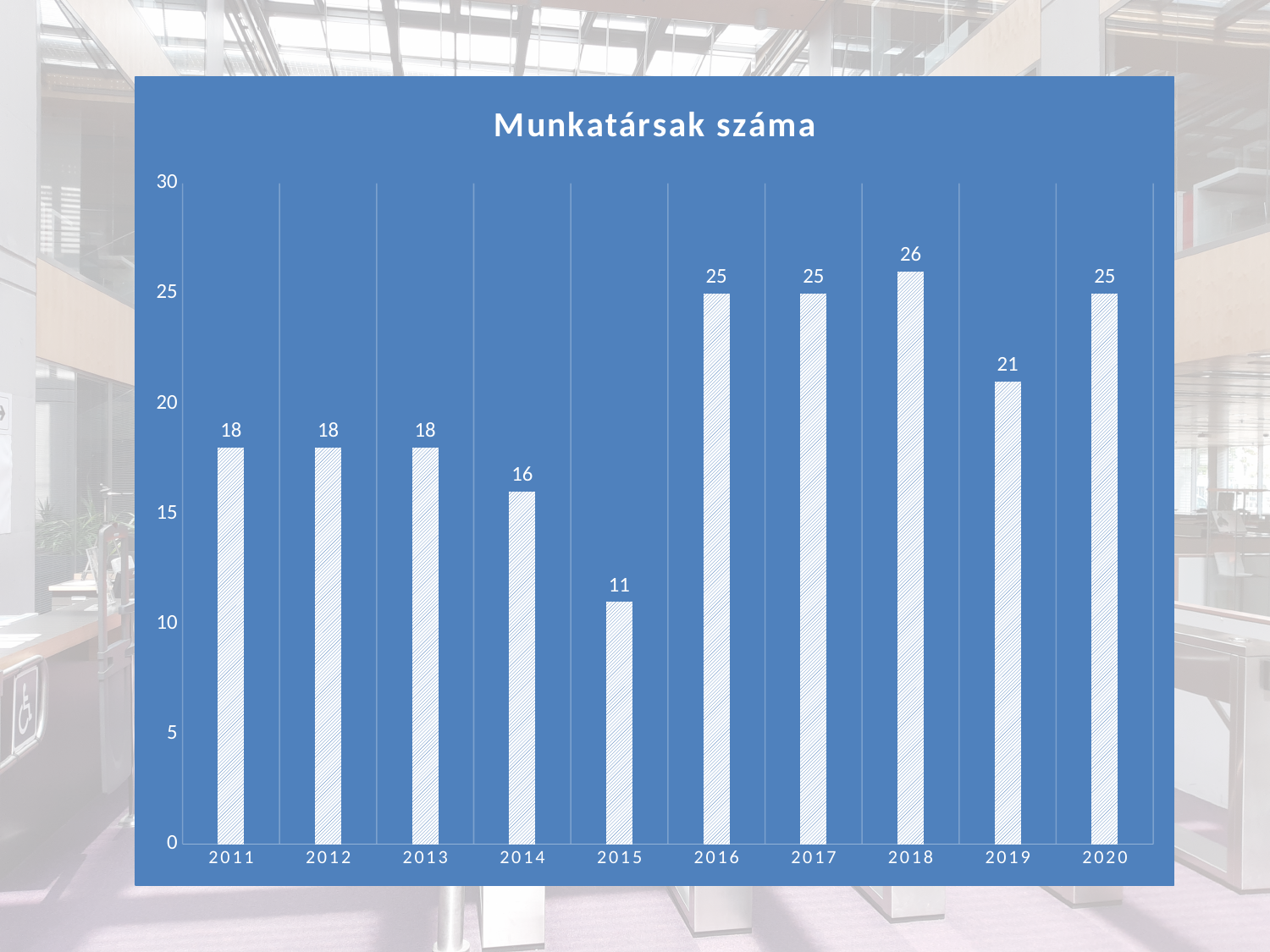
What is the value for 2018 in the chart? 26 Which is larger, the value for 2014 or the value for 2019? 2019 What is the difference between the values for 2016 and 2015? 14 How many years are shown on the x axis of the chart? 10 Which year has the lowest value in the chart? 2015 What is the title of the chart? Munkatársak száma Do the values rise or fall from 2013 to 2015? fall Is the value for 2017 greater or less than 20? greater What is the value for 2019 in the chart? 21 Which year has the highest value in the chart? 2018 What kind of chart is shown on the slide? bar chart What is the value for 2015 in the chart? 11